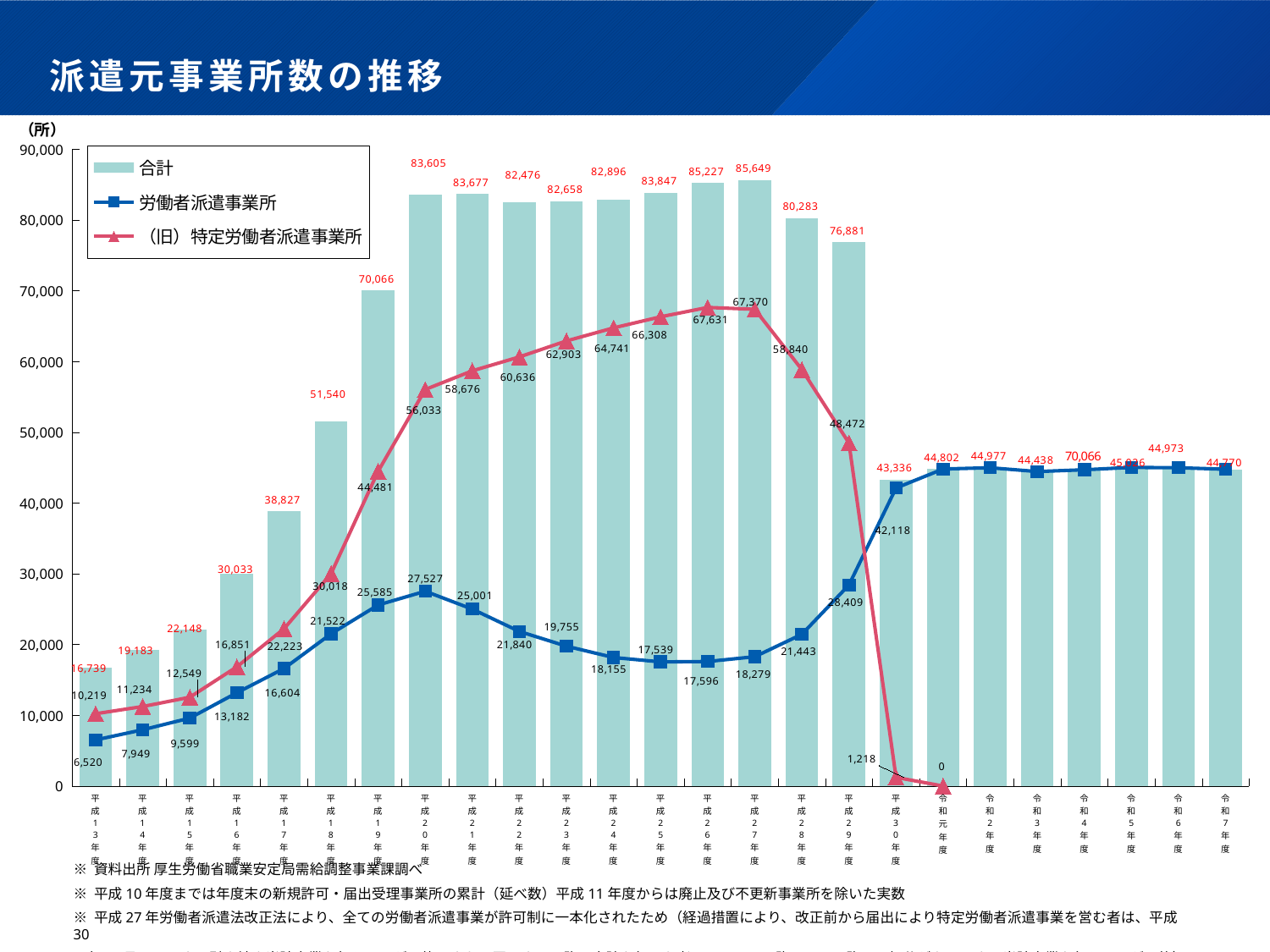
In which fiscal year is the 合計 value highest? 平成27年度 In which fiscal year is the 合計 value lowest? 平成13年度 What kind of chart is shown on the slide? A bar chart combined with line charts Is the 労働者派遣事業所 value for 令和3年度 greater or less than 40,000? greater What is the 合計 value for 平成27年度? 85,649 How many series does the legend list? 3 For 平成29年度, which is larger: 労働者派遣事業所 or （旧）特定労働者派遣事業所? （旧）特定労働者派遣事業所 What is the 労働者派遣事業所 value for 平成20年度? 27,527 What is the （旧）特定労働者派遣事業所 value for 令和元年度? 0 How many fiscal-year categories are plotted along the x axis? 25 Does the （旧）特定労働者派遣事業所 line rise or fall from 平成13年度 to 平成26年度? rise What is the difference between the 合計 values for 平成27年度 and 平成28年度? 5,366